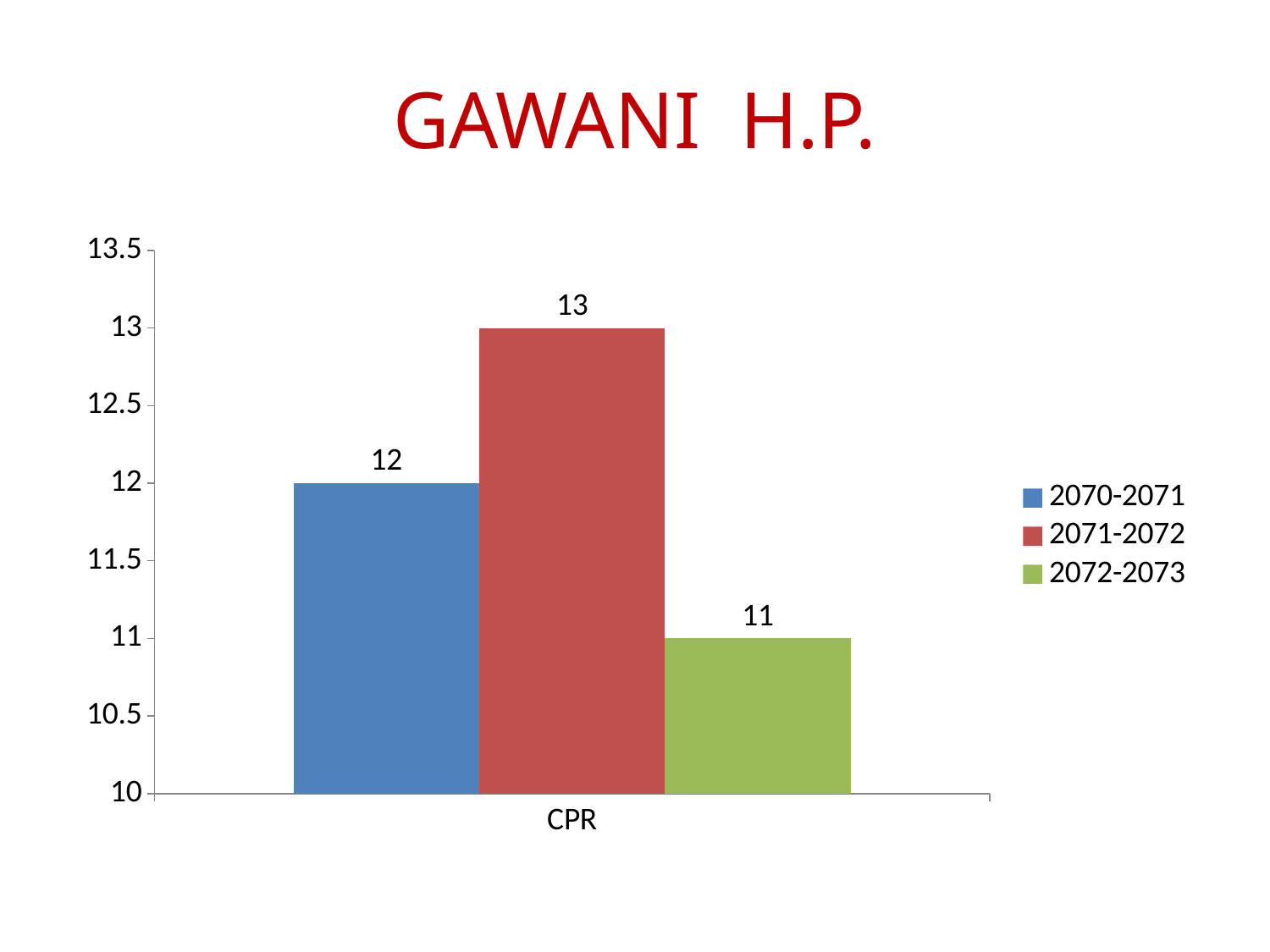
What is the category label on the x axis? CPR Which series has the highest CPR value? 2071-2072 What kind of chart is shown on the slide? bar chart How many series does the legend list? 3 Which series has the lowest CPR value? 2072-2073 Which is larger, the CPR value for 2070-2071 or for 2071-2072? 2071-2072 What is the difference between the CPR values for 2071-2072 and 2072-2073? 2 What is the title of the slide? GAWANI H.P. What is the CPR value for 2070-2071? 12 What is the CPR value for 2071-2072? 13 What is the difference between the CPR values for 2070-2071 and 2072-2073? 1 What is the CPR value for 2072-2073? 11